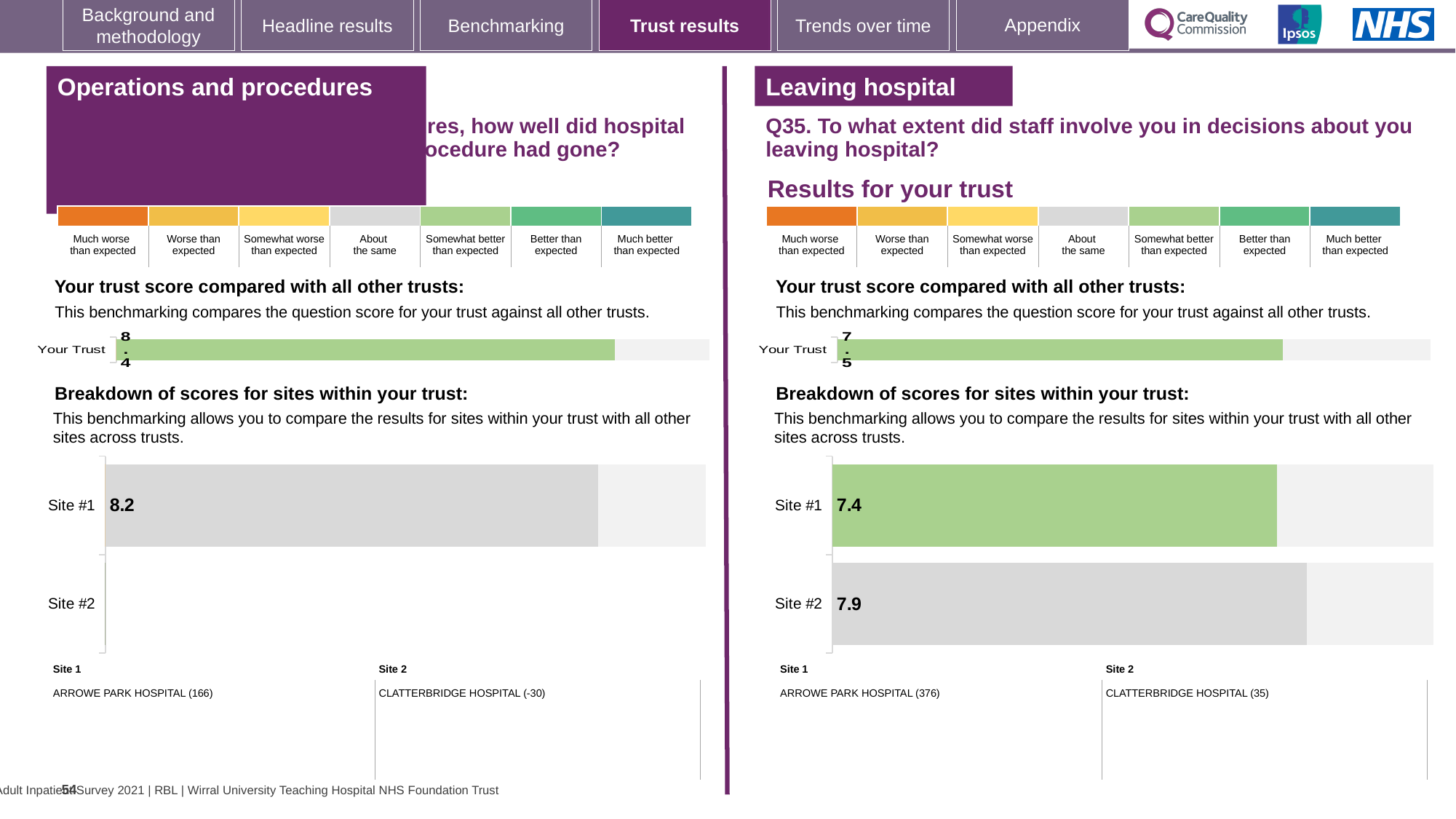
On the Leaving hospital (Q35) site breakdown chart, what is the score for Site #1? 7.4 On the Leaving hospital (Q35) site breakdown chart, which site has the higher score? Site #2 On the Leaving hospital (Q35) site breakdown chart, which site has the lower score? Site #1 On the Leaving hospital (Q35) site breakdown chart, what is the difference between the Site #2 and Site #1 scores? 0.5 What type of chart is used for the site breakdown on the Leaving hospital (Q35) section? bar chart How many sites are listed on the Leaving hospital (Q35) site breakdown chart? 2 On the Leaving hospital (Q35) site breakdown chart, what is the score for Site #2? 7.9 On the Operations and procedures 'Your trust score compared with all other trusts' chart on the left, what is the score for Your Trust? 8.4 On the Leaving hospital (Q35) site breakdown chart, which site's bar is coloured green? Site #1 On the Leaving hospital (Q35) 'Your trust score compared with all other trusts' chart, what is the score for Your Trust? 7.5 On the Operations and procedures site breakdown chart on the left, what is the score for Site #1? 8.2 Is the Site #1 score on the Operations and procedures chart (left) larger or smaller than the Site #1 score on the Leaving hospital chart (right)? larger